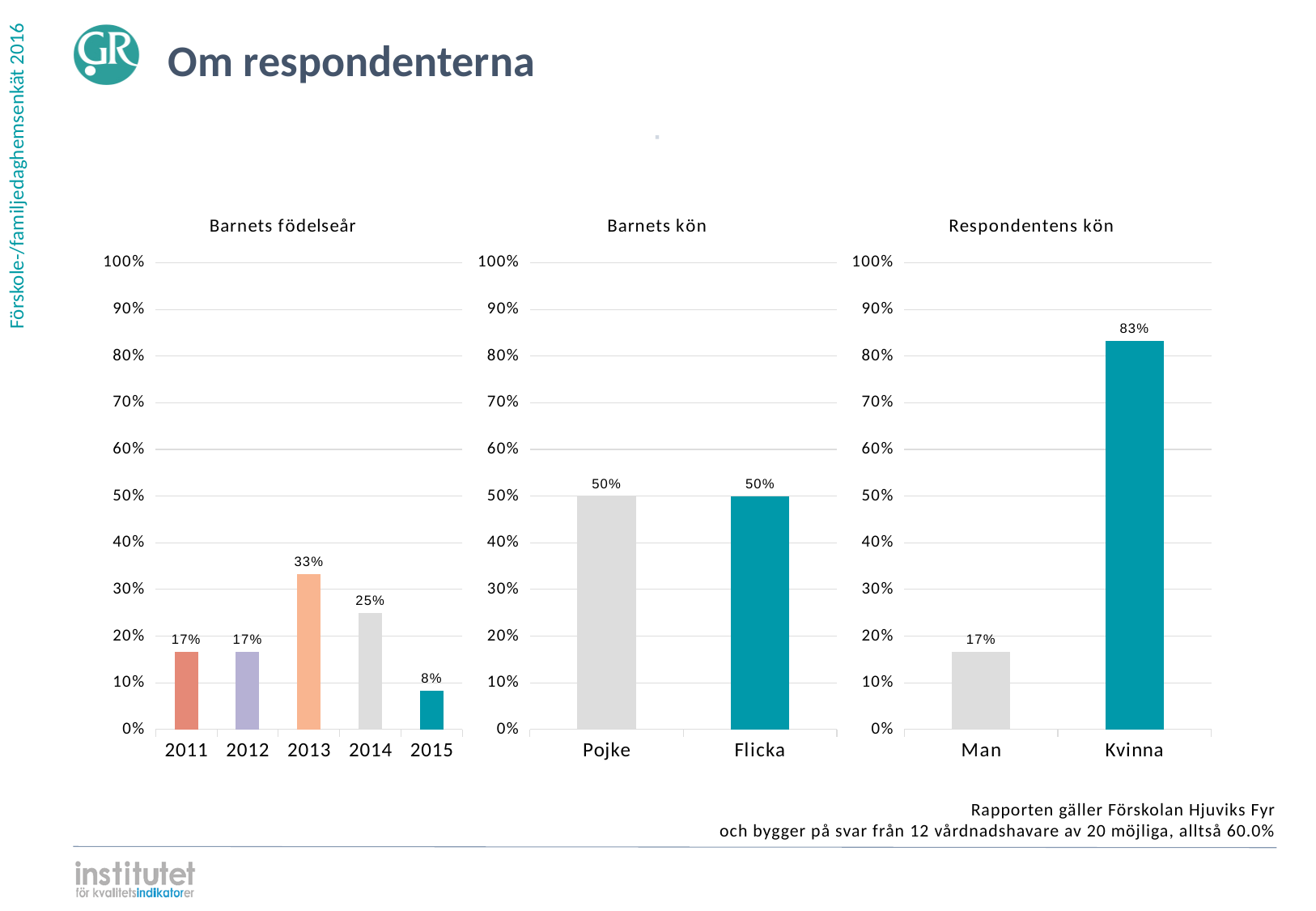
What kind of chart is the 'Respondentens kön' chart? Bar chart In the 'Barnets födelseår' chart, which year has the lowest value? 2015 In the 'Barnets kön' chart, what is the difference between the values for Pojke and Flicka? 0% In the 'Barnets födelseår' chart, is the value for 2014 greater or less than 20%? greater In the 'Barnets födelseår' chart, which year has the highest value? 2013 In the 'Barnets födelseår' chart, what is the value for 2013? 33% In the 'Barnets födelseår' chart, how many years are shown on the x axis? 5 In the 'Barnets födelseår' chart, what is the difference between the values for 2013 and 2014? 8% In the 'Respondentens kön' chart, what is the difference between the values for Kvinna and Man? 66% In the 'Respondentens kön' chart, what is the value for Kvinna? 83% In the 'Barnets kön' chart, what is the value for Pojke? 50% In the 'Respondentens kön' chart, which category is larger, Man or Kvinna? Kvinna